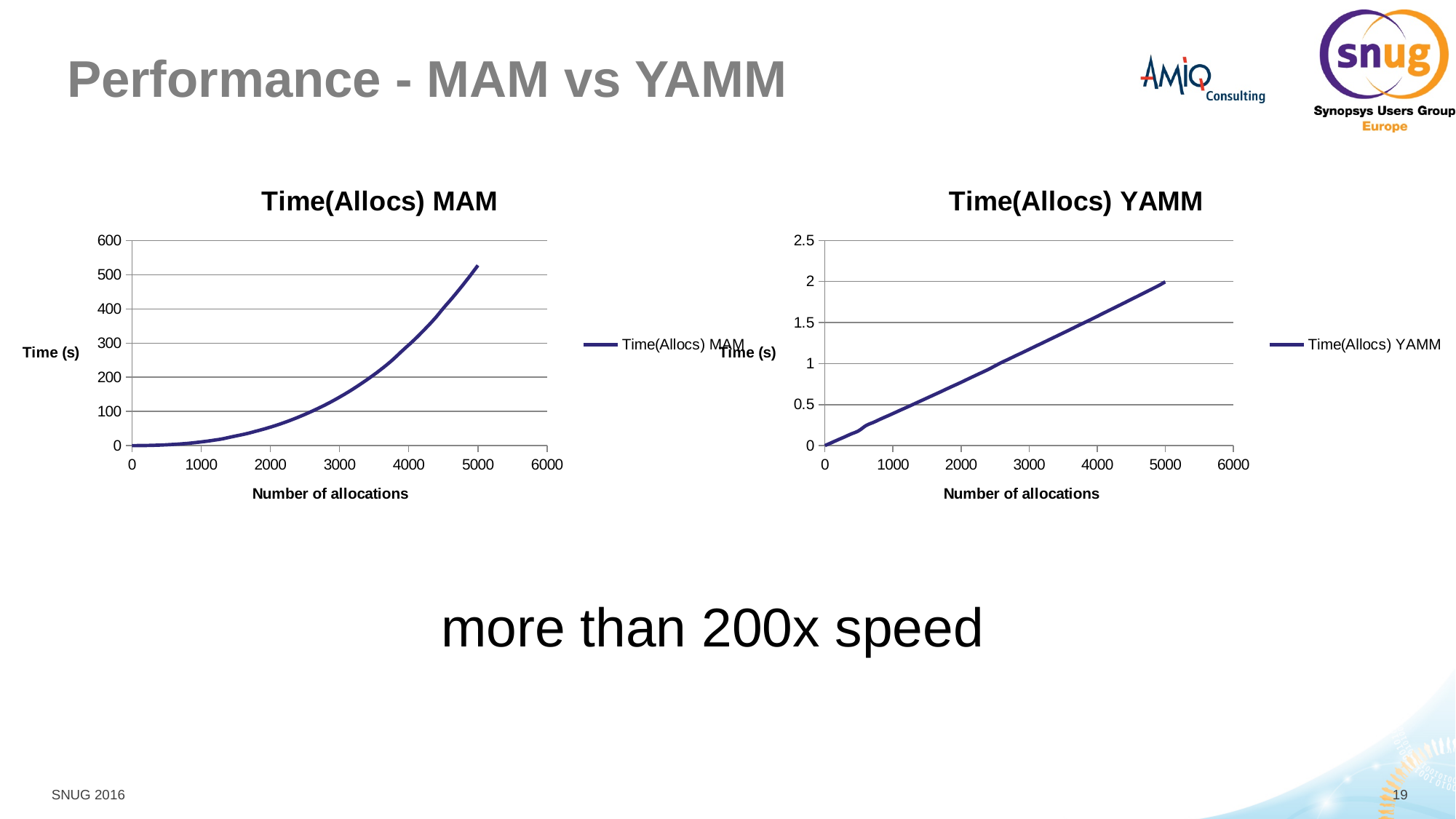
What kind of chart is the Time(Allocs) YAMM chart? line chart What kind of chart is the Time(Allocs) MAM chart? line chart In the Time(Allocs) MAM chart, is the time at 5000 allocations greater or less than 500? greater In the Time(Allocs) MAM chart, is the time at 3000 allocations greater or less than 200? less In the Time(Allocs) YAMM chart, does the time rise or fall as the number of allocations increases? rise In the Time(Allocs) MAM chart, is the time at 3000 allocations greater or less than 100? greater In the Time(Allocs) MAM chart, does the time rise or fall as the number of allocations increases? rise What is the label of the x axis on the Time(Allocs) MAM chart? Number of allocations What is the highest tick value on the y axis of the Time(Allocs) YAMM chart? 2.5 How many series does the legend of the Time(Allocs) YAMM chart list? 1